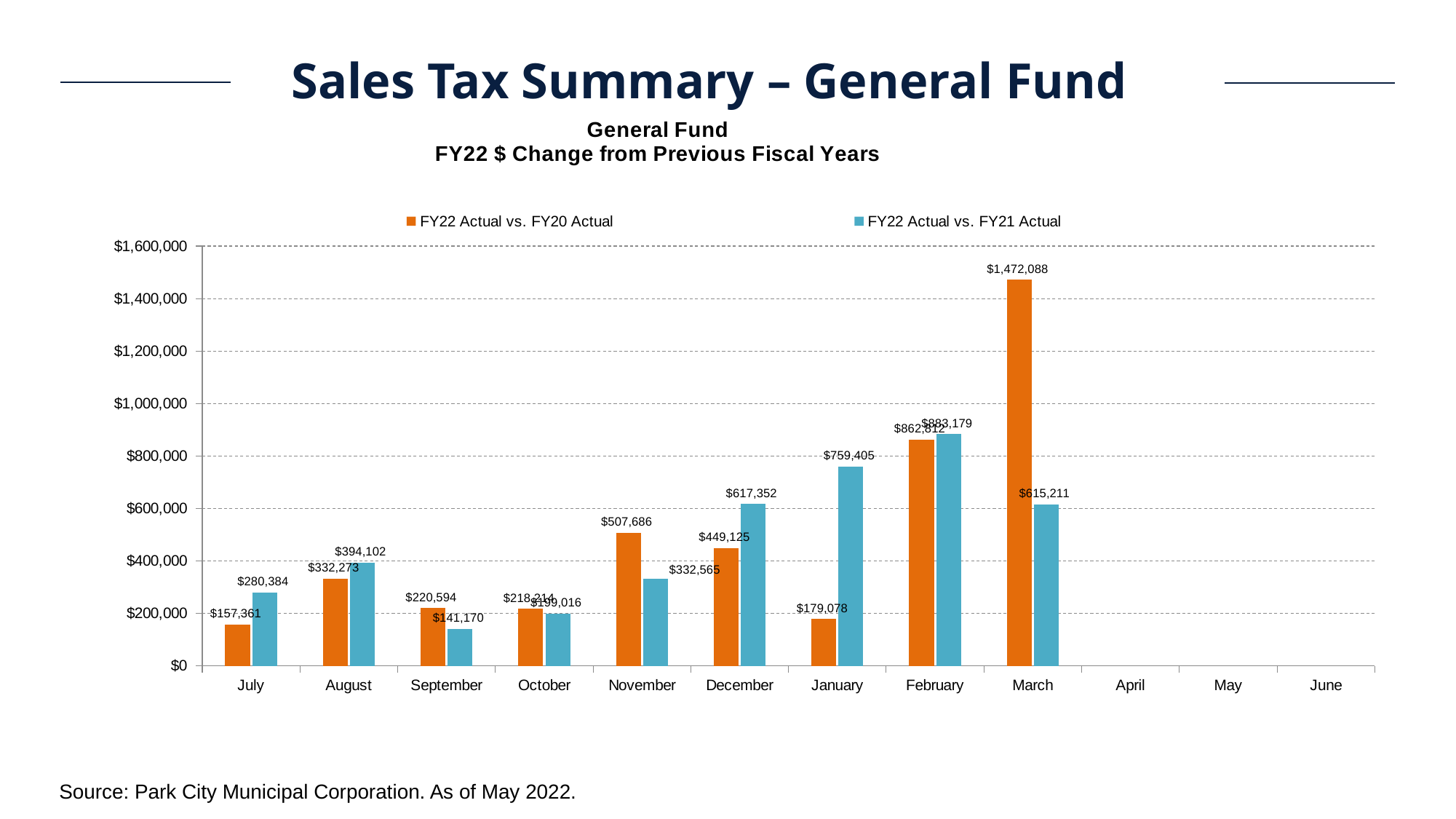
What is the value for January in the FY22 Actual vs. FY21 Actual series? $759,405 What is the value for September in the FY22 Actual vs. FY21 Actual series? $141,170 What kind of chart is shown on the slide? bar chart Is the January value for FY22 Actual vs. FY21 Actual greater or less than $800,000? less In December, how much larger is the FY22 Actual vs. FY21 Actual value than the FY22 Actual vs. FY20 Actual value? $168,227 Which month has the highest value in the FY22 Actual vs. FY20 Actual series? March What is the value for March in the FY22 Actual vs. FY20 Actual series? $1,472,088 How many series does the legend list? 2 Which month has the lowest value in the FY22 Actual vs. FY21 Actual series? September How many months are listed on the x axis? 12 In November, which series has the larger value: FY22 Actual vs. FY20 Actual or FY22 Actual vs. FY21 Actual? FY22 Actual vs. FY20 Actual In July, what is the difference between the FY22 Actual vs. FY21 Actual value and the FY22 Actual vs. FY20 Actual value? $123,023